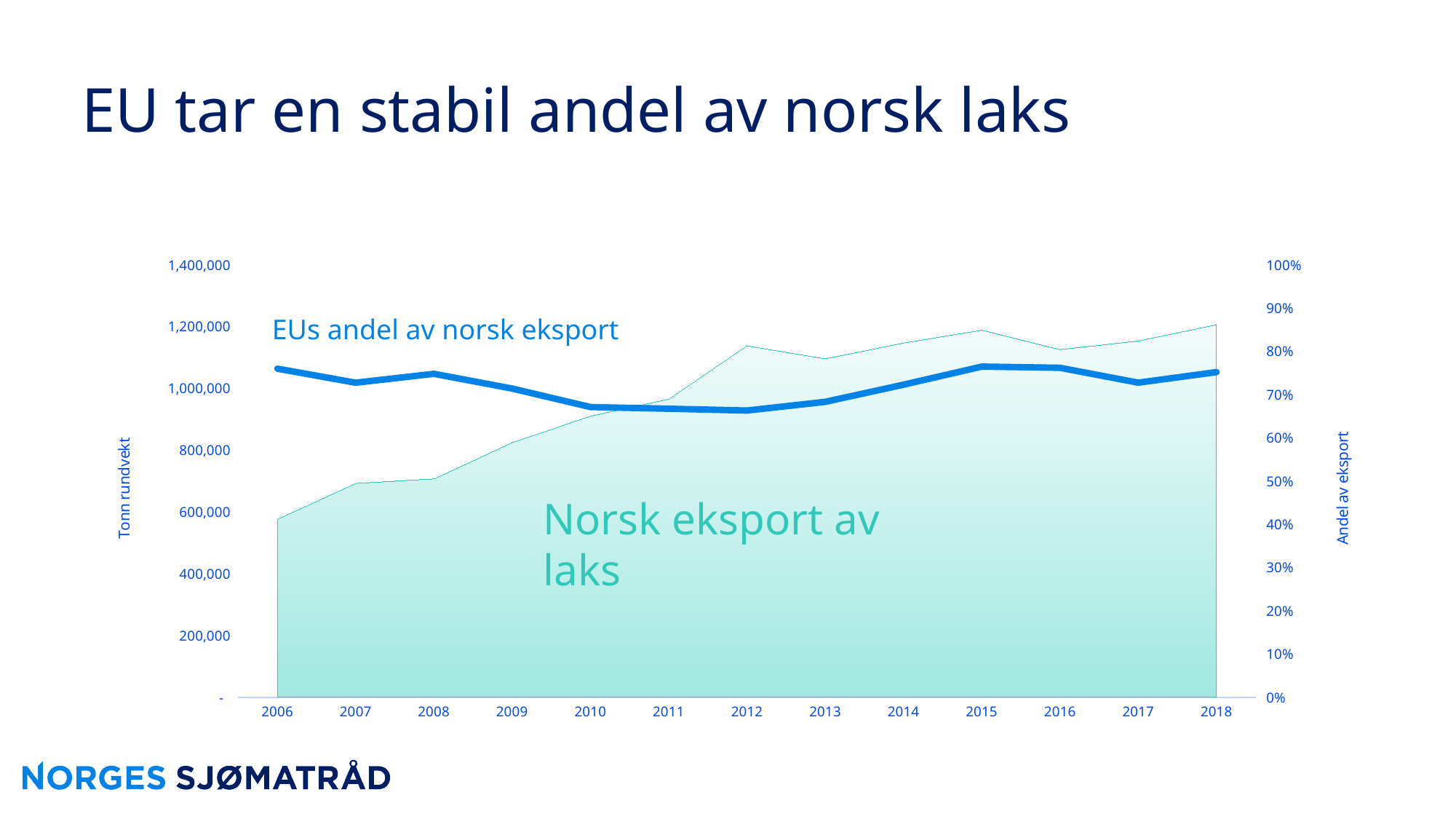
Is the value for EUs andel av norsk eksport in 2006 greater or less than 70%? greater Does Norsk eksport av laks generally rise or fall from 2006 to 2018? rise How many data series are shown in the chart? 2 Which is larger, EUs andel av norsk eksport in 2006 or in 2012? 2006 Which year has the lowest value for Norsk eksport av laks? 2006 Is the value for Norsk eksport av laks in 2006 greater or less than 800,000? less What is the title of the left vertical axis? Tonn rundvekt Is the value for Norsk eksport av laks in 2018 greater or less than 1,000,000? greater Which year has the highest value for Norsk eksport av laks? 2018 How many years are plotted along the x axis? 13 What kind of chart is shown on the slide? A combined area and line chart